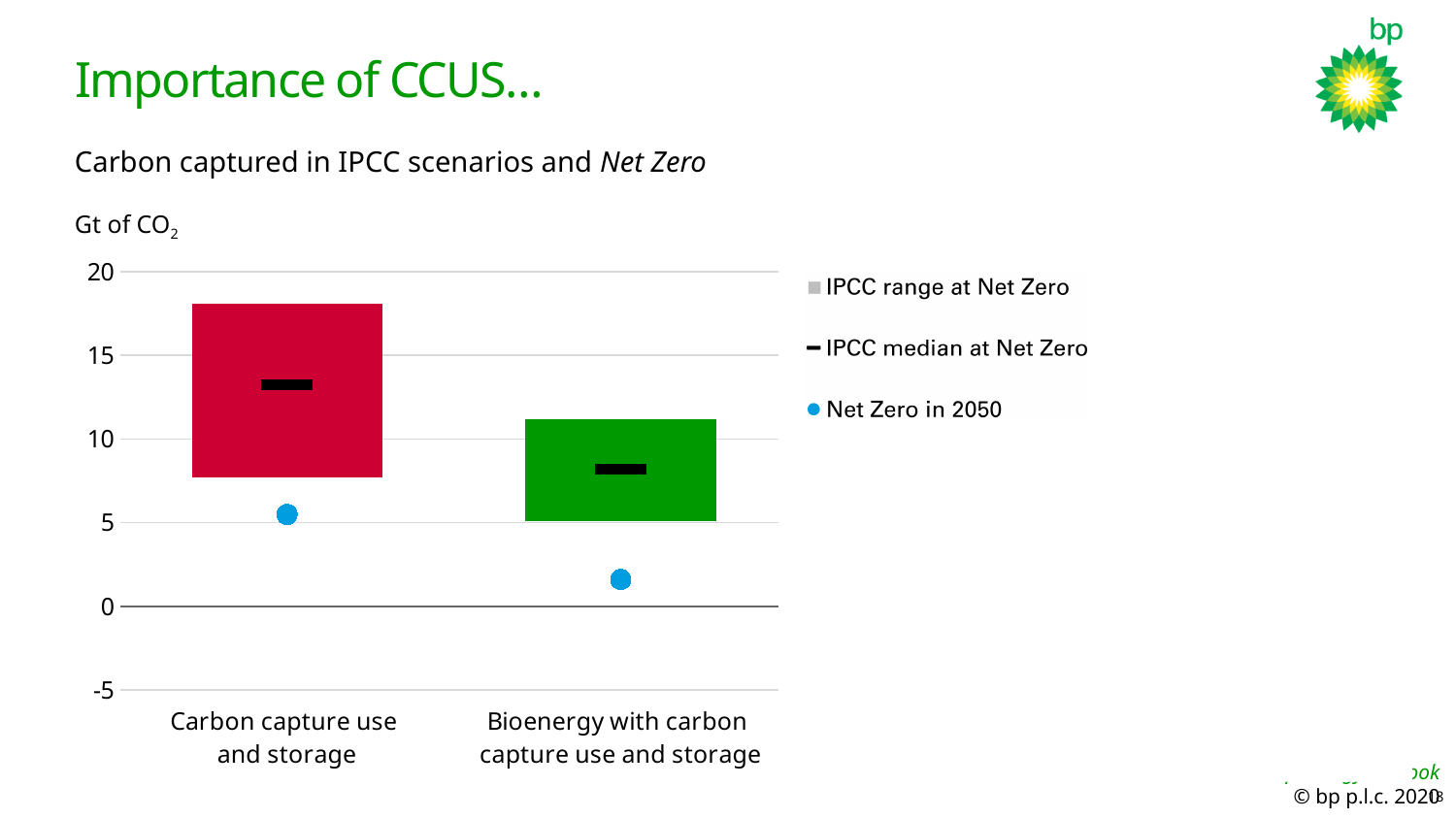
Is the top of the IPCC range at Net Zero for Carbon capture use and storage greater or less than 15? greater Is the IPCC median at Net Zero for Bioenergy with carbon capture use and storage greater or less than 10? less Is the Net Zero in 2050 value for Bioenergy with carbon capture use and storage greater or less than 5? less What kind of chart is shown on the slide? bar chart Which category has the higher IPCC median at Net Zero? Carbon capture use and storage How many series does the legend list? 3 What unit is shown on the chart's y axis? Gt of CO2 How many categories are shown on the x axis? 2 What is the title of the chart? Carbon captured in IPCC scenarios and Net Zero Which category has the higher Net Zero in 2050 value? Carbon capture use and storage